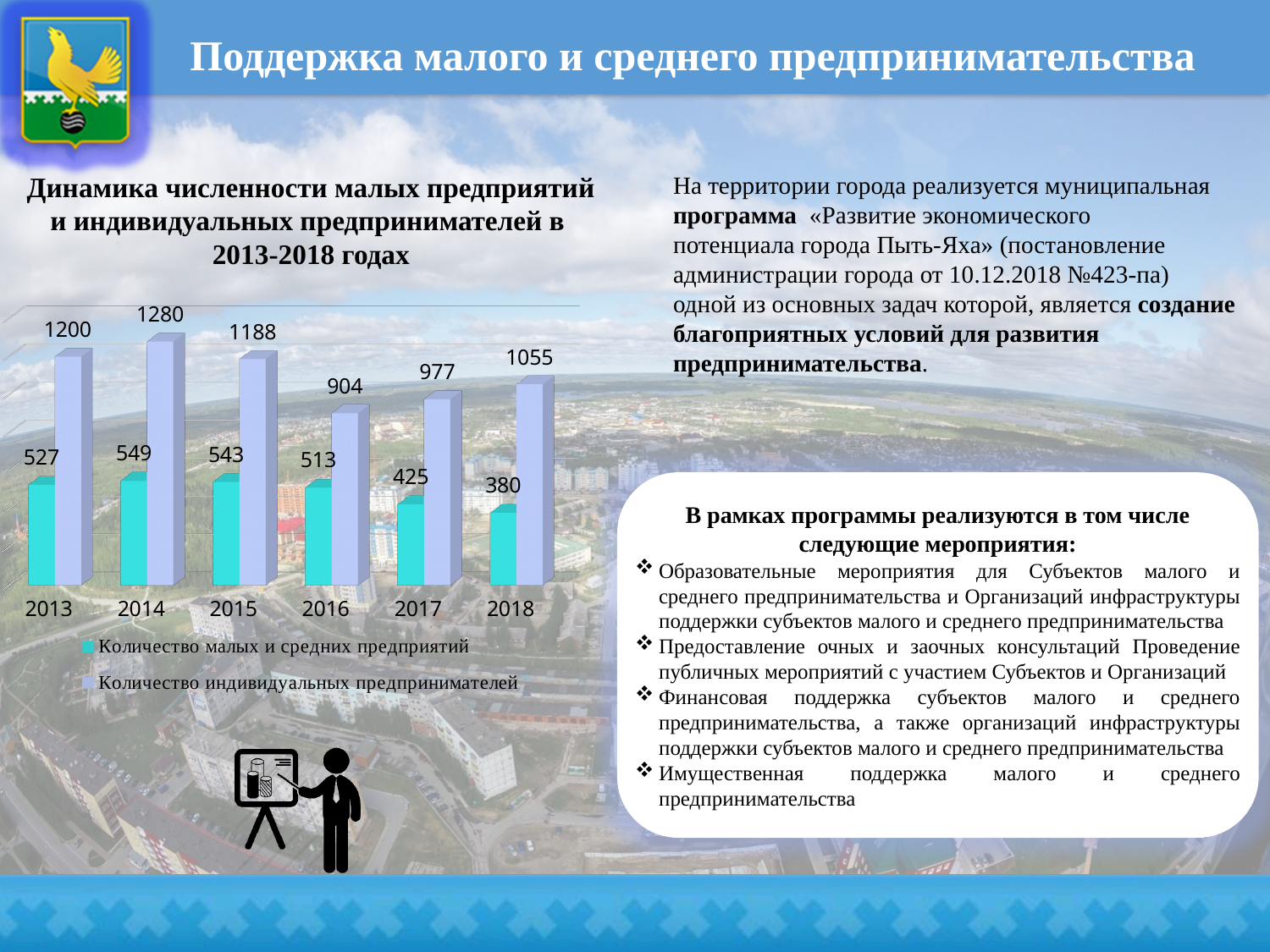
In which year is 'Количество индивидуальных предпринимателей' highest? 2014 What is the difference between 'Количество малых и средних предприятий' in 2013 and in 2018? 147 Does 'Количество малых и средних предприятий' rise or fall from 2015 to 2018? Fall What is the difference between 'Количество индивидуальных предпринимателей' in 2014 and in 2016? 376 What is the value for 'Количество индивидуальных предпринимателей' in 2014? 1280 How many series does the chart legend list? 2 How many years are shown on the x axis of the chart? 6 Which is larger: 'Количество малых и средних предприятий' in 2014 or in 2017? 2014 What kind of chart is shown on the slide? Bar chart What is the value for 'Количество малых и средних предприятий' in 2016? 513 What is the value for 'Количество малых и средних предприятий' in 2018? 380 In which year is 'Количество малых и средних предприятий' lowest? 2018